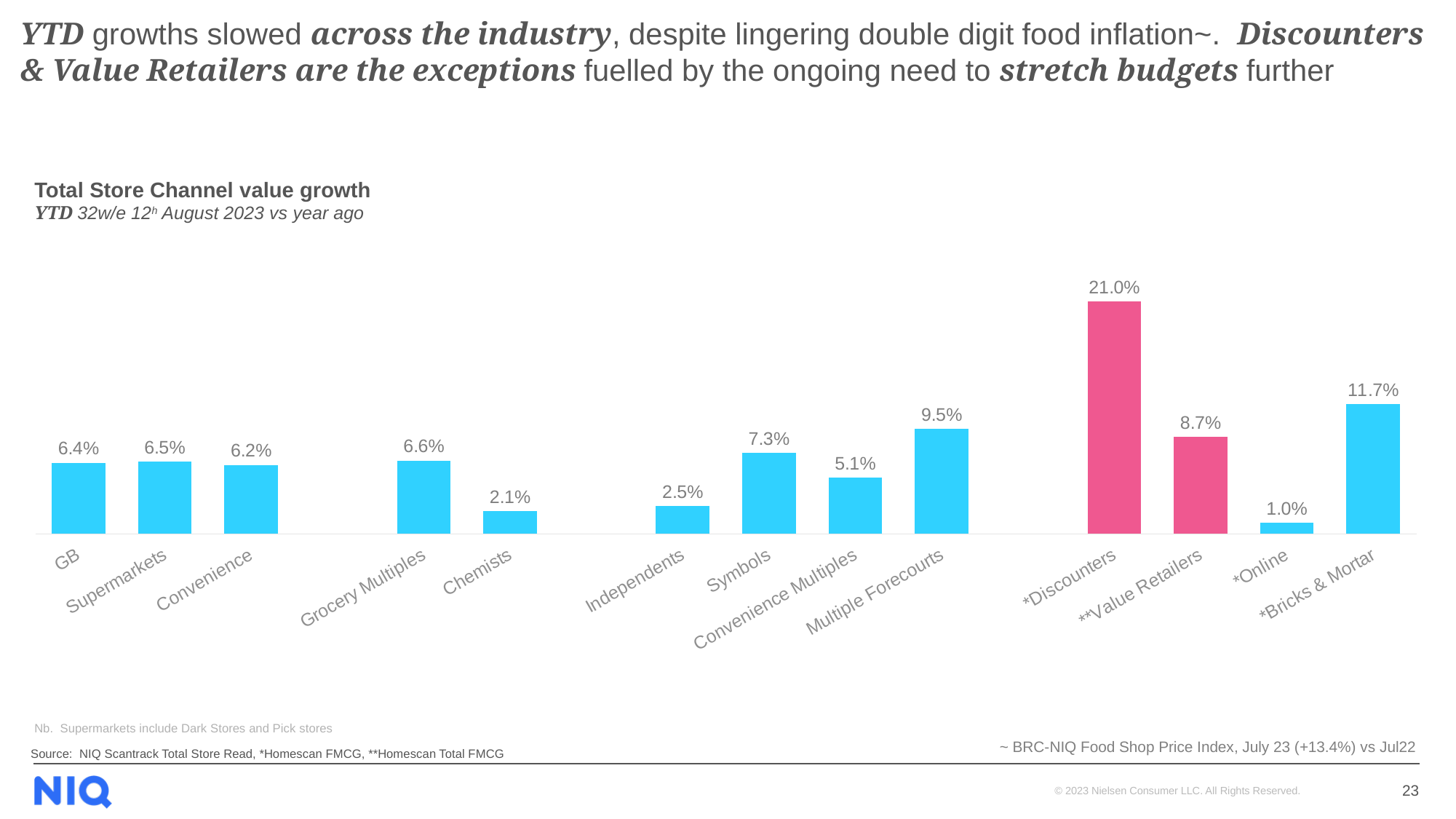
Which has higher value growth, Symbols or Independents? Symbols What is the value growth for *Bricks & Mortar? 11.7% Which channel has the highest value growth? *Discounters What is the value growth for *Discounters? 21.0% What is the value growth for Supermarkets? 6.5% What is the value growth for Chemists? 2.1% How many channels are shown in the chart? 13 What is the title of the chart? Total Store Channel value growth What type of chart is shown on the slide? Bar chart What is the difference in value growth between Multiple Forecourts and Convenience Multiples? 4.4 percentage points What is the difference in value growth between *Discounters and **Value Retailers? 12.3 percentage points Which channel has the lowest value growth? *Online